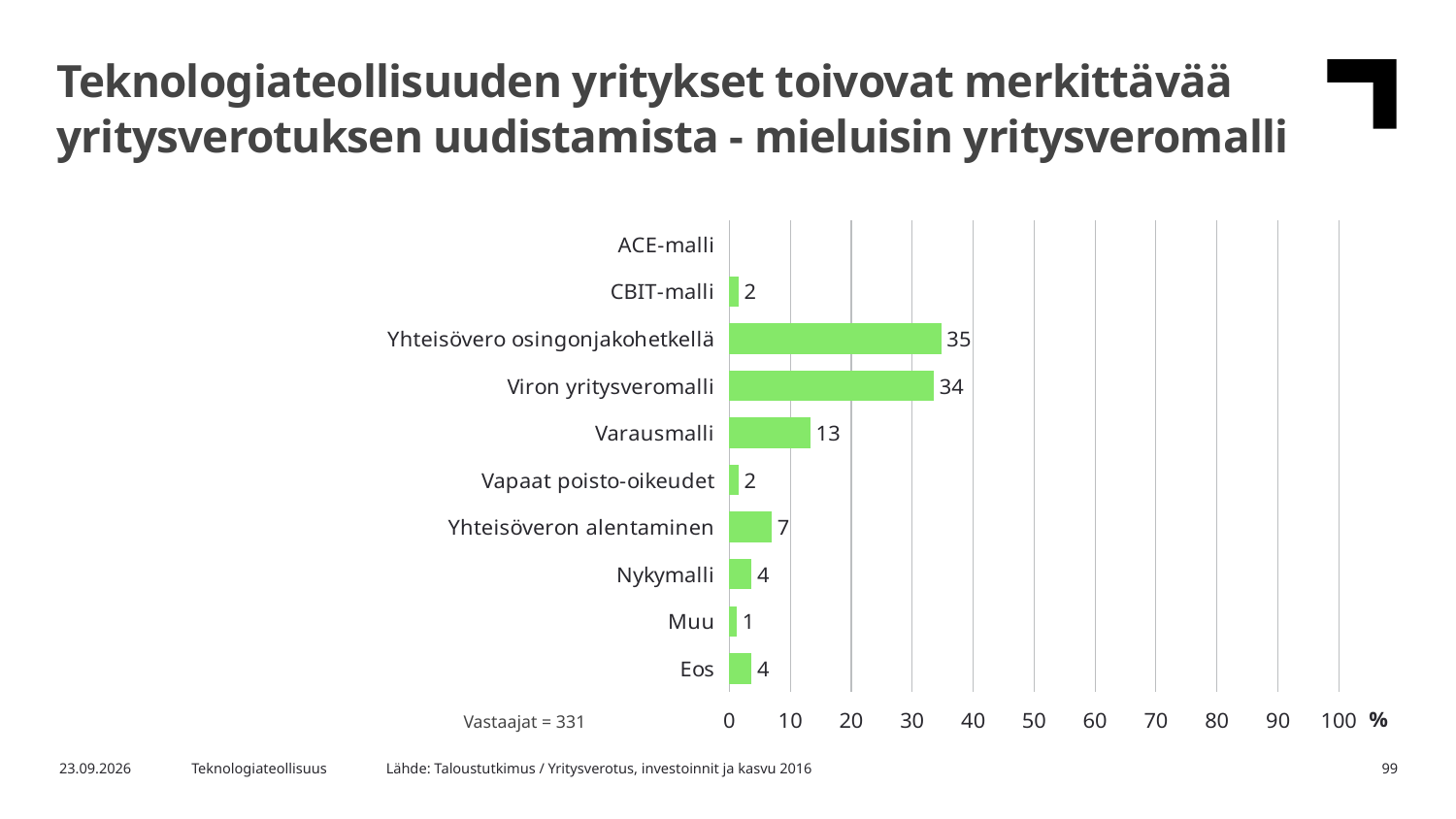
Which is larger, the value for Nykymalli or the value for Yhteisöveron alentaminen? Yhteisöveron alentaminen What is the value for Varausmalli? 13 What is the value for Yhteisöveron alentaminen? 7 What is the value for Viron yritysveromalli? 34 What kind of chart is shown on the slide? Bar chart What is the difference between the values for Yhteisövero osingonjakohetkellä and Viron yritysveromalli? 1 What is the value for Yhteisövero osingonjakohetkellä? 35 What is the difference between the values for Varausmalli and Yhteisöveron alentaminen? 6 How many categories are shown on the chart? 10 Which category has the highest value? Yhteisövero osingonjakohetkellä Is the value for Viron yritysveromalli greater or less than 30? greater What is the value for Muu? 1